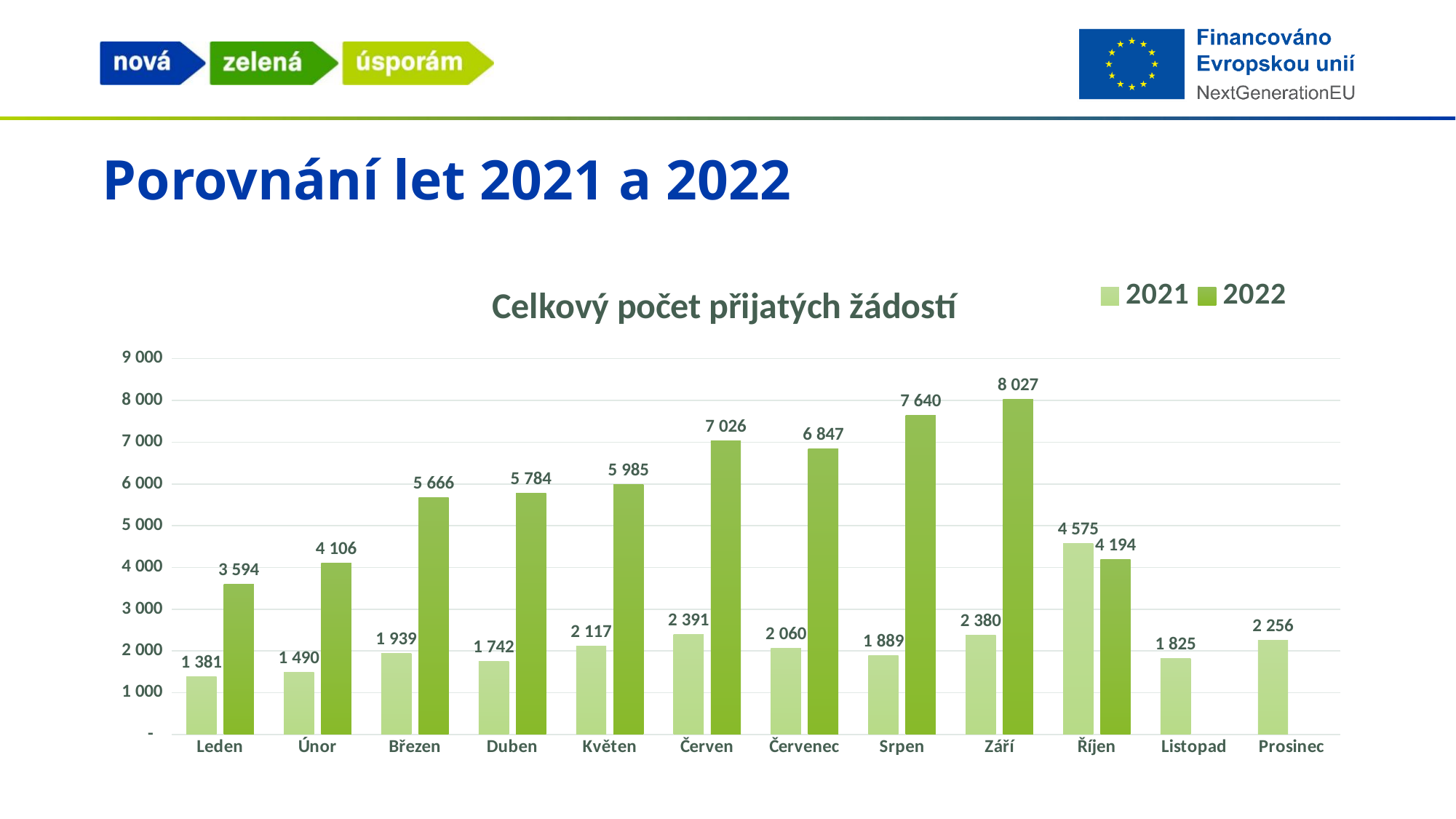
What is the value for 2021 in Leden? 1 381 What is the title of the chart? Celkový počet přijatých žádostí How many series does the legend list? 2 What is the difference between the 2022 and 2021 values in Červen? 4 635 How many months are shown on the x axis? 12 Is the value for 2022 in Srpen greater or less than 7 000? greater Which month has the lowest value for the 2021 series? Leden Which is larger in Říjen, the 2021 value or the 2022 value? 2021 What kind of chart is shown on the slide? bar chart What is the value for 2022 in Září? 8 027 Which month has the highest value for the 2022 series? Září What is the value for 2021 in Říjen? 4 575